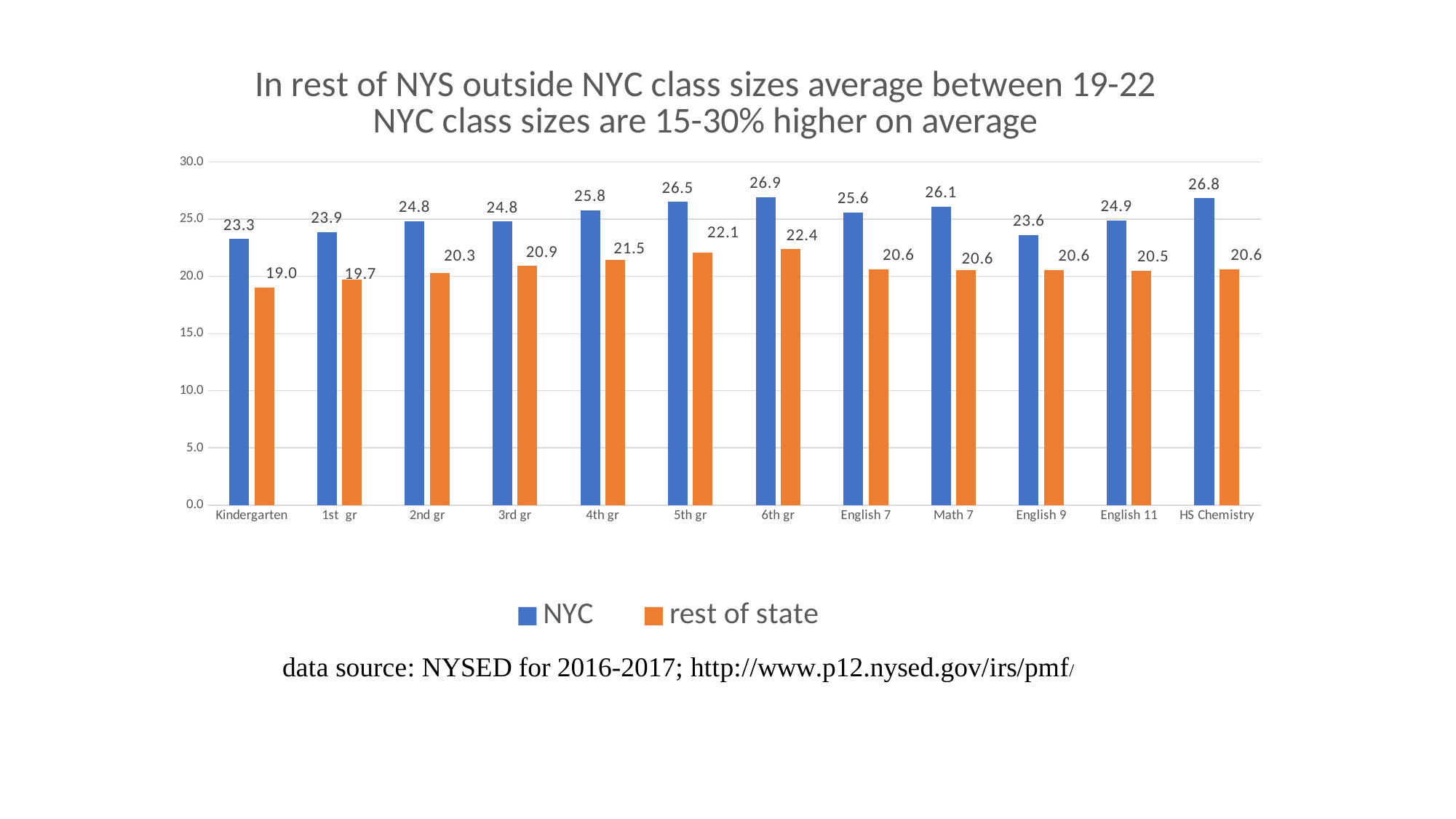
How many series does the legend list? 2 Which colour represents the rest of state series? orange Which is larger, the NYC value for 4th gr or the NYC value for English 9? 4th gr What is the difference between the NYC and rest of state values for HS Chemistry? 6.2 Which category has the lowest rest of state class size? Kindergarten Which category has the highest NYC class size? 6th gr What is the rest of state average class size for Kindergarten? 19.0 Is the rest of state value for 3rd gr greater or less than 25.0? less How many categories are shown on the x axis? 12 What kind of chart is shown on the slide? bar chart What is the rest of state value for 5th gr? 22.1 What is the NYC average class size for 6th gr? 26.9